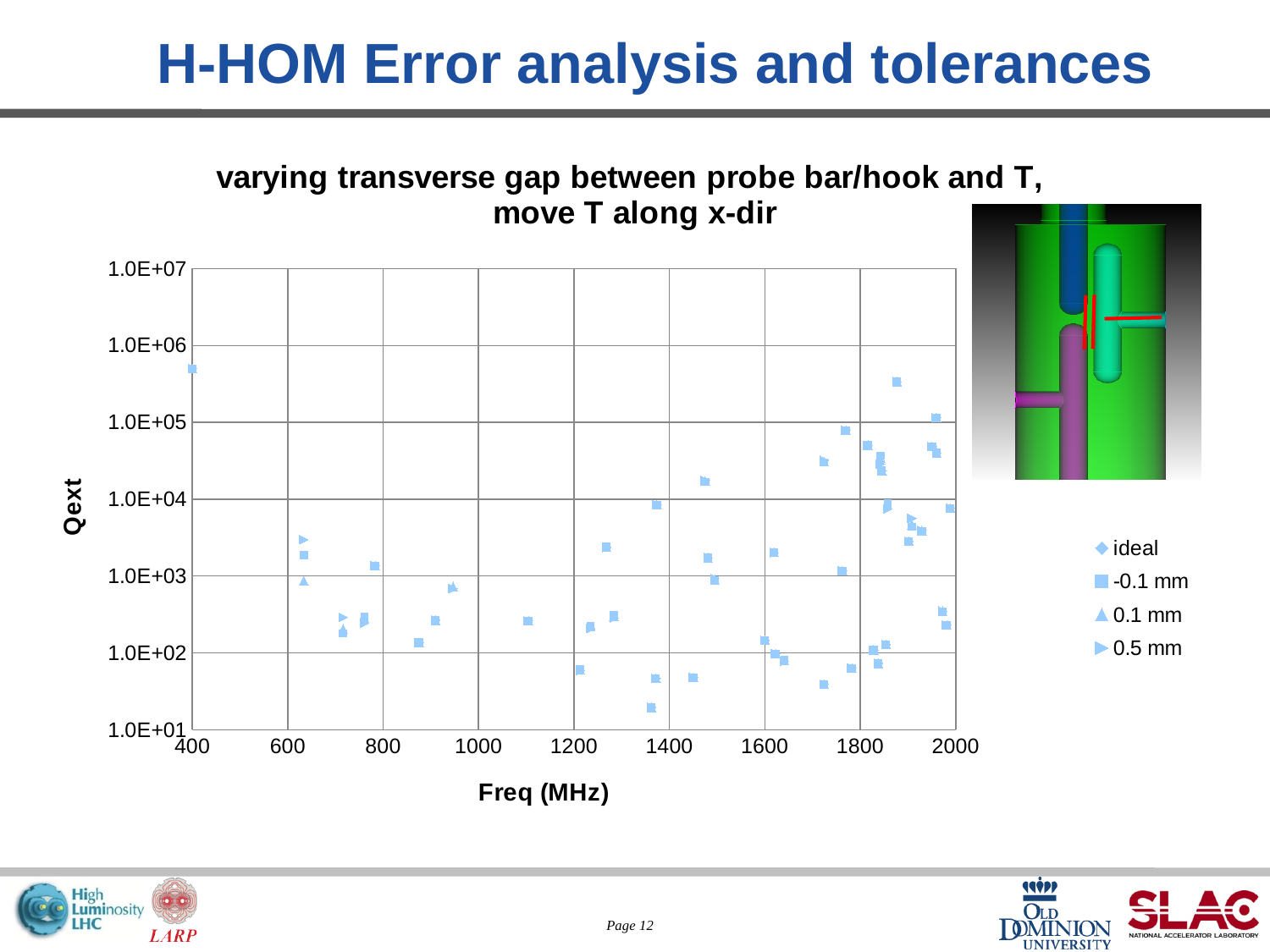
Is the Qext value of the highest point plotted between 1800 and 2000 MHz greater or less than 1.0E+05? greater What is the lowest value shown on the Freq (MHz) axis? 400 Is the Qext value of the point plotted near 1100 MHz greater or less than 1.0E+03? less Which point has the highest Qext on the chart: the one near 400 MHz or the one near 1100 MHz? The one near 400 MHz Is the Qext value of the point plotted at about 400 MHz greater or less than 1.0E+05? greater What is the highest value shown on the Qext axis? 1.0E+07 What is the title of the chart? varying transverse gap between probe bar/hook and T, move T along x-dir How many series does the chart legend list? 4 What kind of chart is shown on the slide? Scatter chart What are the series names listed in the chart legend? ideal, -0.1 mm, 0.1 mm, 0.5 mm